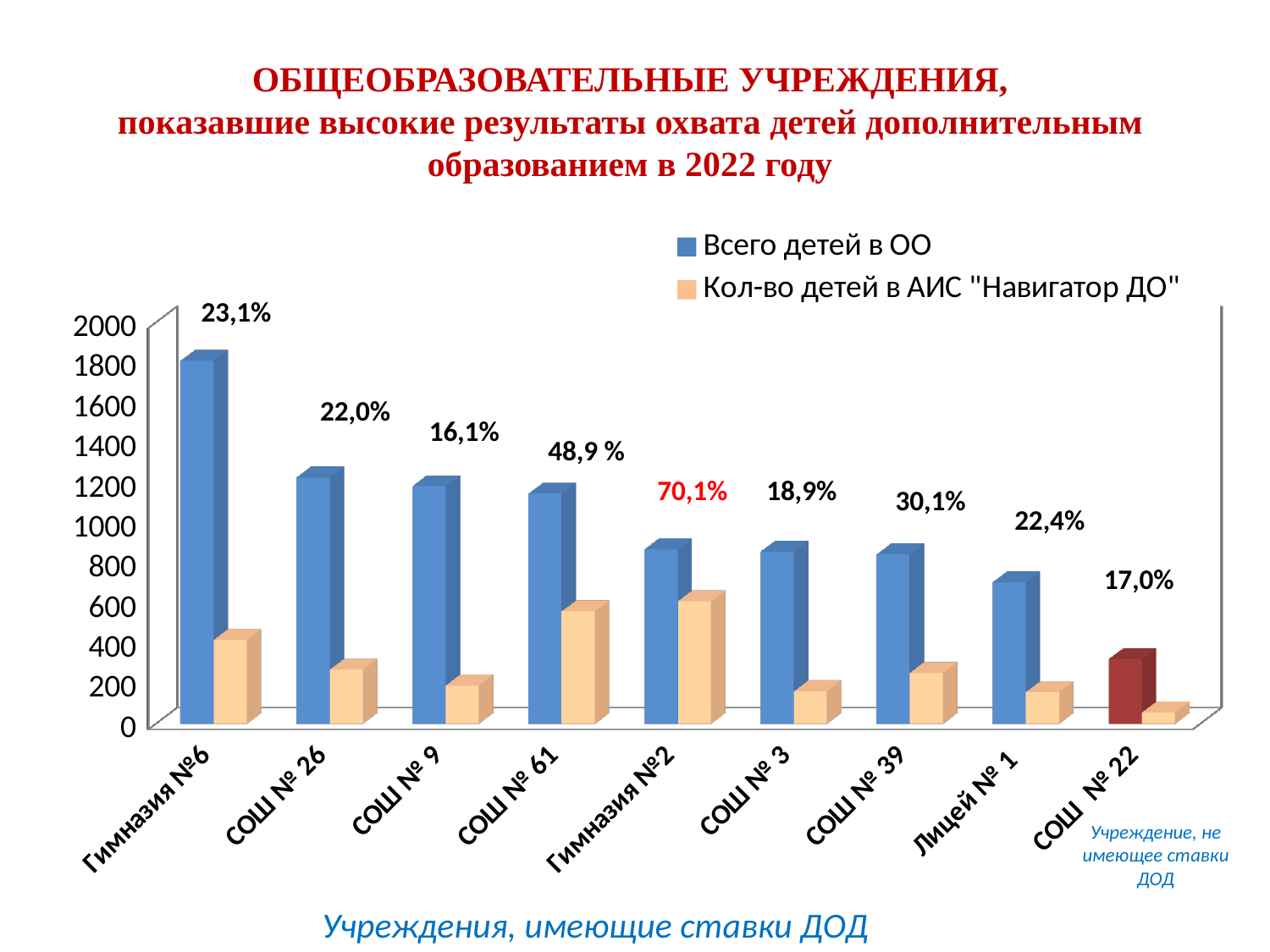
What percentage label is printed above the bars for СОШ № 39? 30,1% How many series does the legend list? 2 Which institution's "Всего детей в ОО" bar is coloured dark red instead of blue? СОШ № 22 Which institution has the highest value for "Всего детей в ОО"? Гимназия №6 What percentage label is printed above the bars for СОШ № 61? 48,9 % Is the "Всего детей в ОО" value for Гимназия №6 greater or less than 1600? greater What percentage label is printed above the bars for Гимназия №2? 70,1% Which institution has the lowest value for "Всего детей в ОО"? СОШ № 22 What kind of chart is shown on the slide? bar chart How many educational institutions (categories) are shown on the x axis? 9 Which is larger, the "Всего детей в ОО" value for Гимназия №6 or for СОШ № 26? Гимназия №6 Is the "Кол-во детей в АИС "Навигатор ДО"" value for Гимназия №2 greater or less than 400? greater